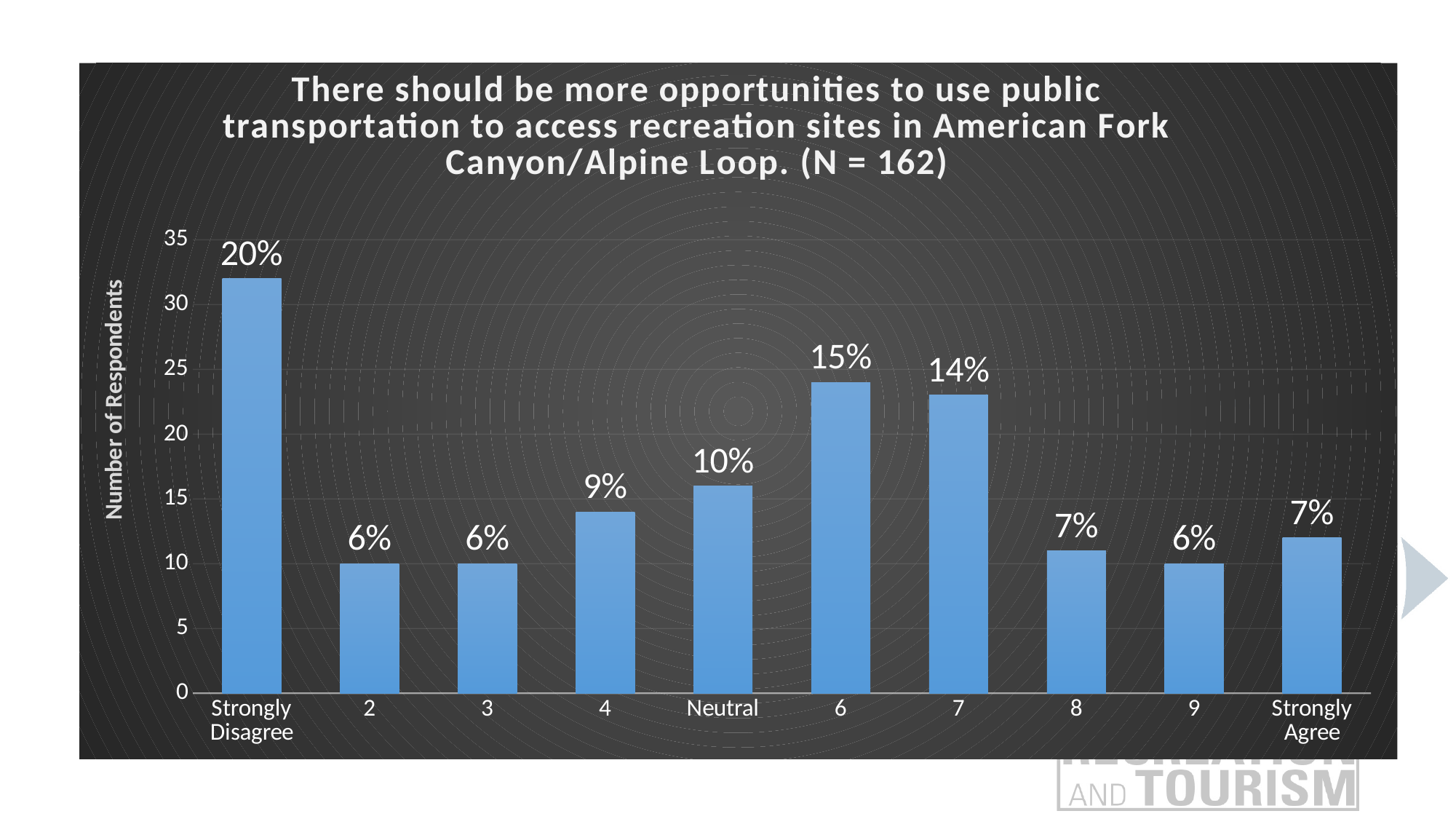
What percentage is shown for category 6? 15% Is the number of respondents for category 4 greater or less than 15? less Is the number of respondents for Strongly Disagree greater or less than 30? greater What percentage is shown for the Strongly Agree bar? 7% What kind of chart is shown on the slide? Bar chart Which category has the highest bar? Strongly Disagree What percentage is shown for the Neutral category? 10% Which has the larger value, category 6 or category 7? Category 6 What is the data label shown for the Strongly Disagree bar? 20% What is the difference in percentage points between the Strongly Disagree label (20%) and the category 2 label (6%)? 14 percentage points What is the label on the vertical axis? Number of Respondents How many categories are shown on the x axis? 10